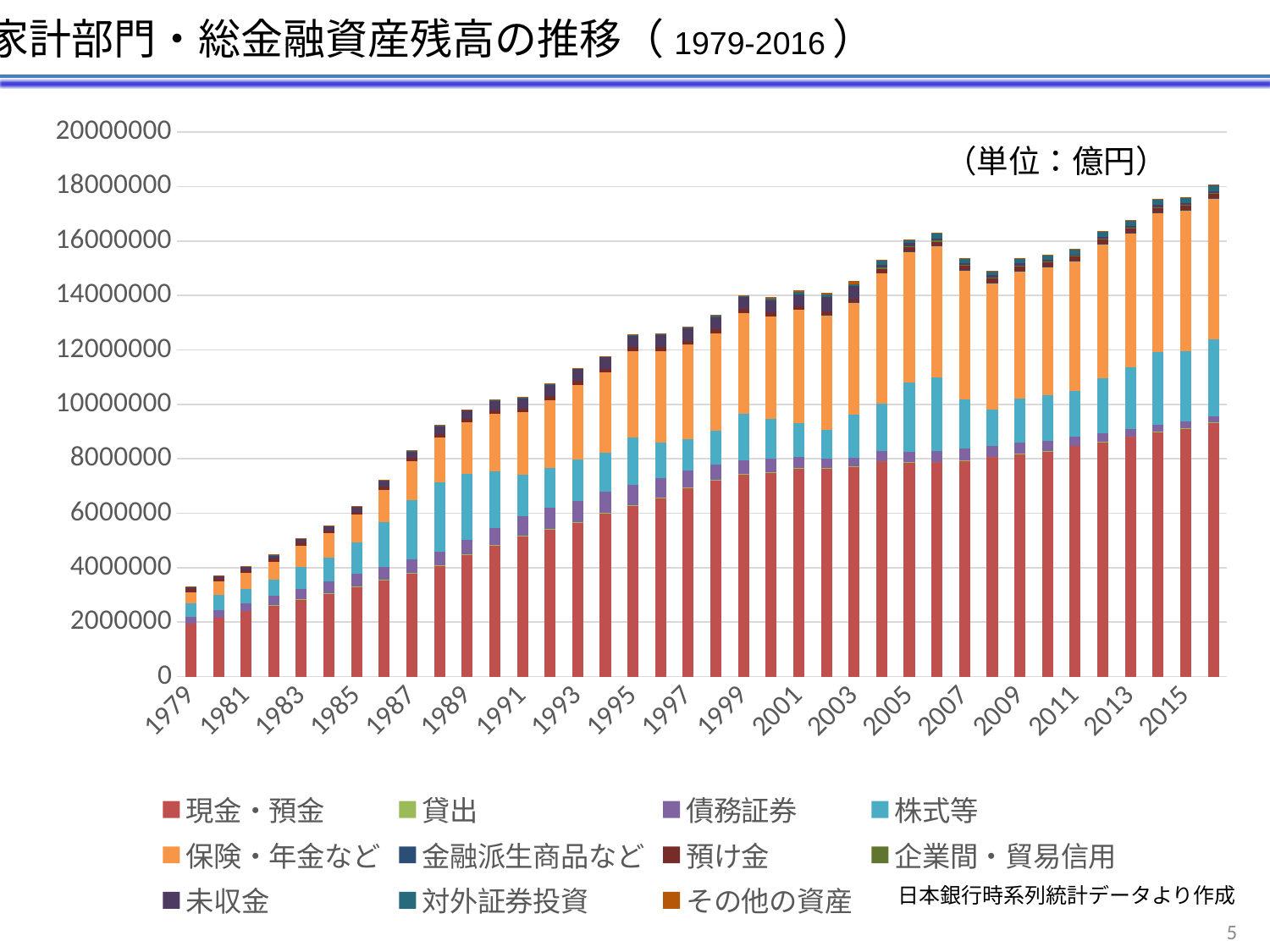
What unit is stated for the values in the chart? 億円 Which year has the lowest total financial assets? 1979 Is the total for 1983 greater or less than 6000000? less Which year has the highest total financial assets? 2016 What kind of chart is shown on the slide? Stacked bar chart How many series does the legend list? 11 Which year has a larger total, 2007 or 2008? 2007 Is the total for 2016 greater or less than 16000000? greater Is the total for 1979 greater or less than 4000000? less How many years (bars) are plotted in the chart? 38 Do the total household financial assets generally rise or fall from 1979 to 2016? Rise